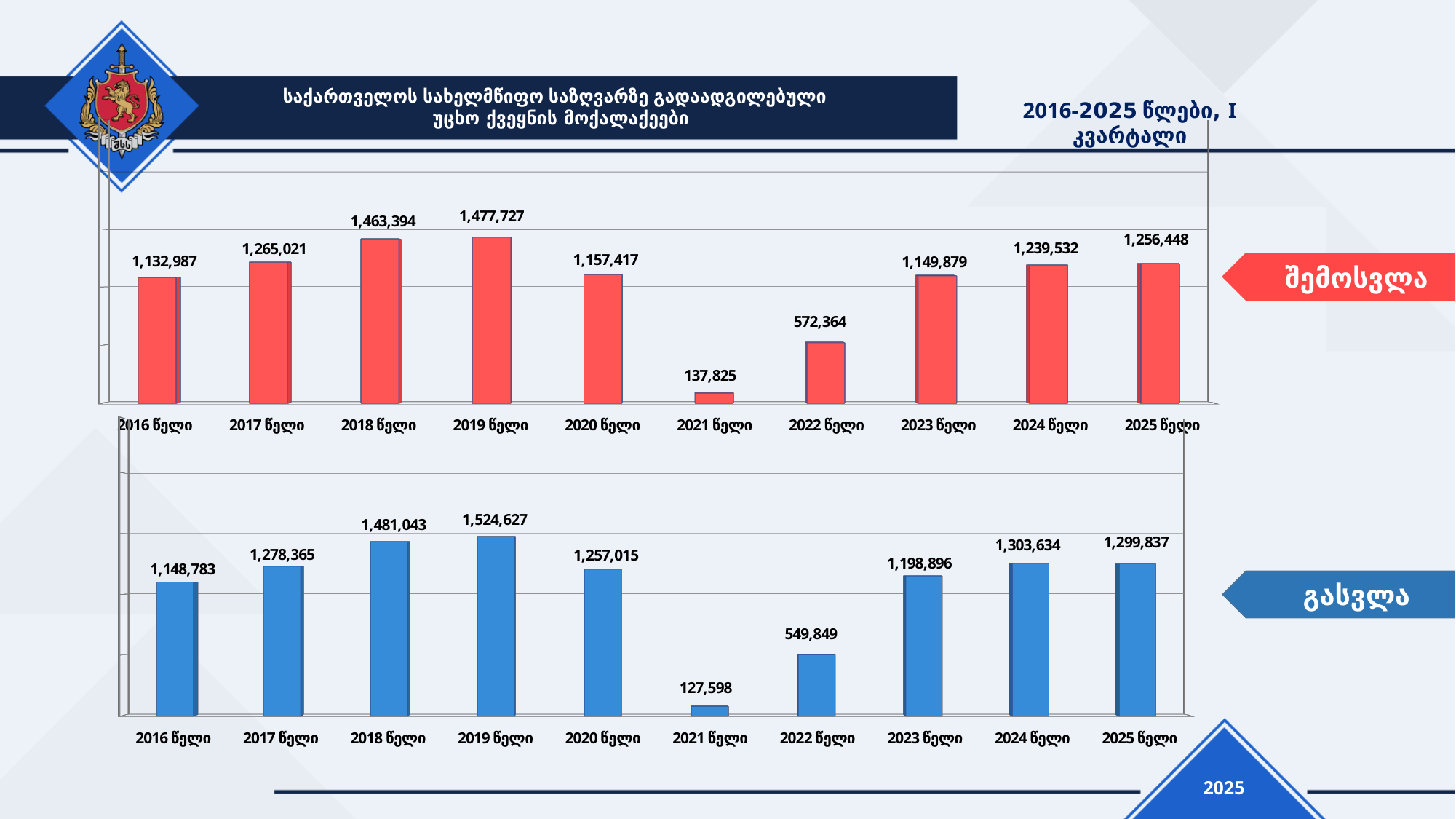
In the bottom (blue) chart, which is larger: the value for 2023 წელი or the value for 2016 წელი? 2023 წელი In the top (red) chart, do the values rise or fall from 2016 წელი to 2019 წელი? rise In the top (red) chart, which year has the highest value? 2019 წელი In the top (red) chart, what is the difference between the values for 2019 წელი and 2018 წელი? 14,333 What colour are the bars in the top chart labelled შემოსვლა? red How many years are shown on the x axis of the top (red) chart? 10 What kind of chart is the bottom (blue) chart? bar chart In the top (red) chart, what is the value for 2019 წელი? 1,477,727 In the top (red) chart, which is larger: the value for 2017 წელი or the value for 2020 წელი? 2017 წელი In the bottom (blue) chart, what is the difference between the values for 2024 წელი and 2025 წელი? 3,797 In the bottom (blue) chart, what is the value for 2022 წელი? 549,849 In the bottom (blue) chart, which year has the lowest value? 2021 წელი